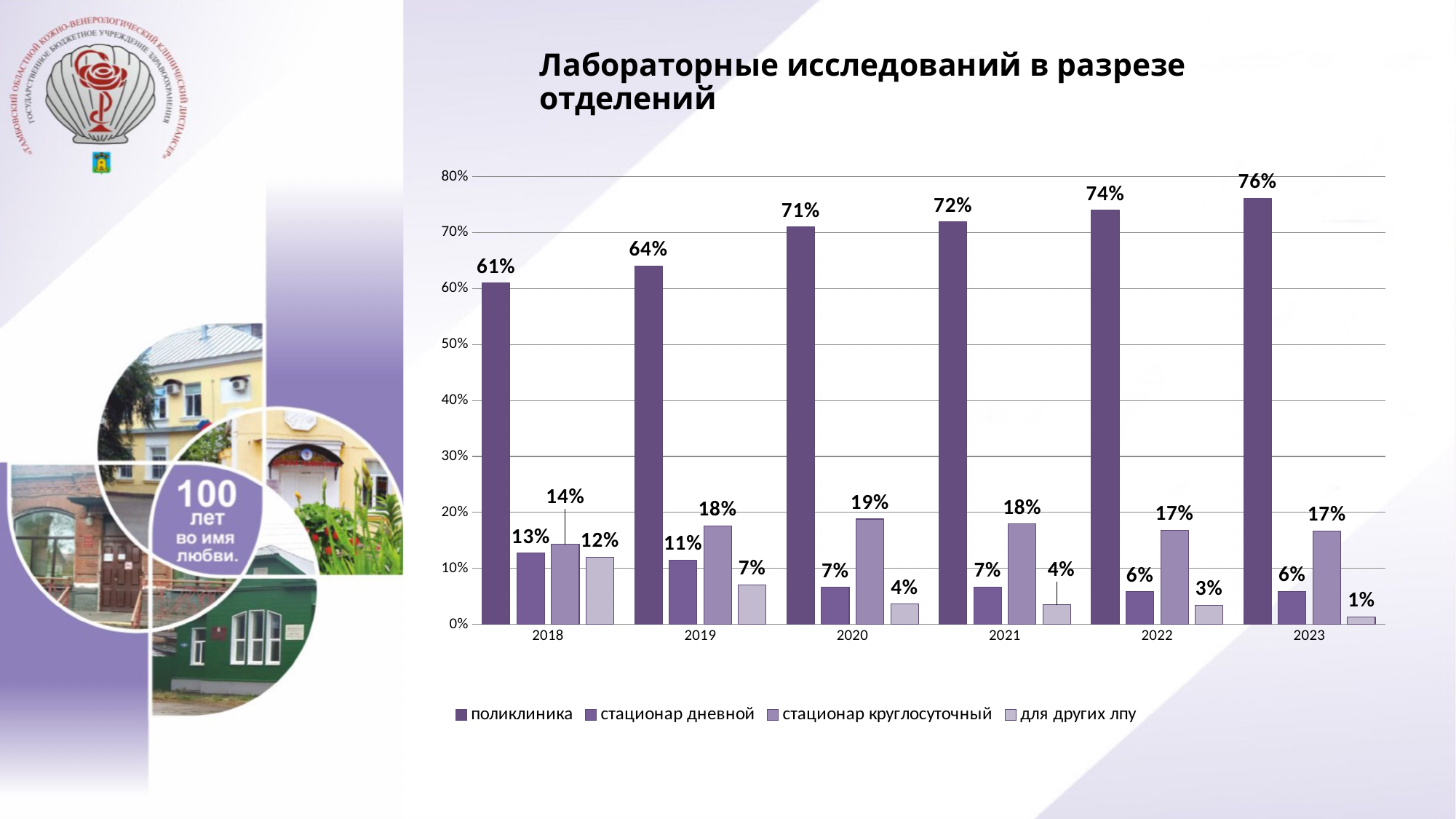
How many series does the legend list? 4 What is the value for поликлиника in 2023? 76% Does the value for поликлиника rise or fall from 2018 to 2023? rise What is the value for стационар круглосуточный in 2020? 19% What is the difference between the поликлиника values in 2023 and 2018? 15% In which year is the value for поликлиника the highest? 2023 Which is larger in 2021: стационар дневной or стационар круглосуточный? стационар круглосуточный What kind of chart is shown on the slide? bar chart What is the value for для других лпу in 2018? 12% What is the value for стационар дневной in 2019? 11% How many years are shown on the x axis? 6 In which year is the value for для других лпу the lowest? 2023